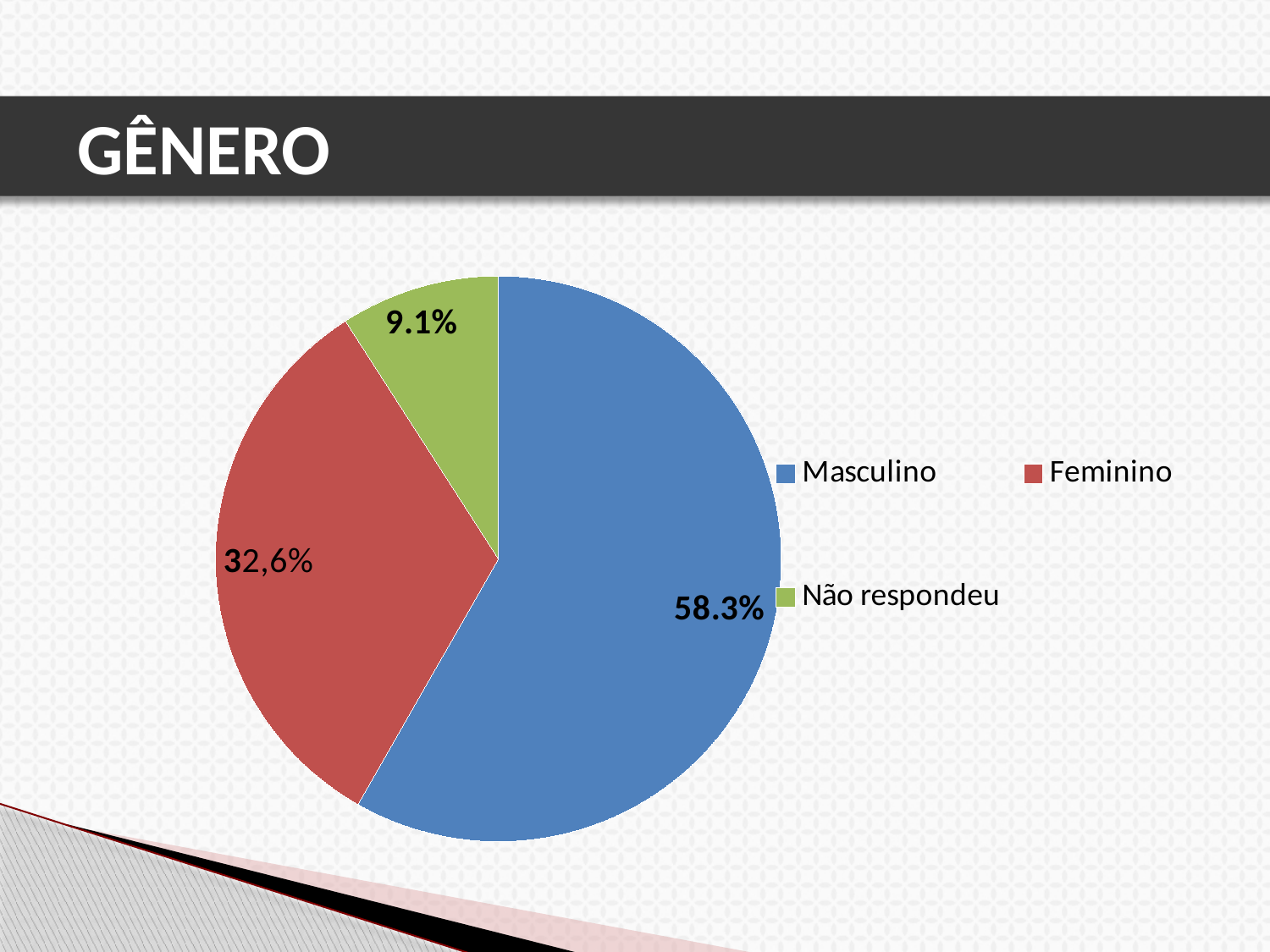
How many entries does the legend list? 3 What is the difference in percentage points between the Masculino and Não respondeu slices? 49.2% How many slices does the pie chart have? 3 What percentage of the pie does the Masculino slice represent? 58.3% Which category has the largest slice of the pie? Masculino What colour is the Masculino slice in the pie chart? Blue What is the title of the slide containing the chart? GÊNERO Which slice is larger, Feminino or Não respondeu? Feminino What percentage is labelled on the Não respondeu slice? 9.1% What kind of chart is shown on the slide? Pie chart Which category has the smallest slice of the pie? Não respondeu What value is shown for the Feminino slice? 32,6%